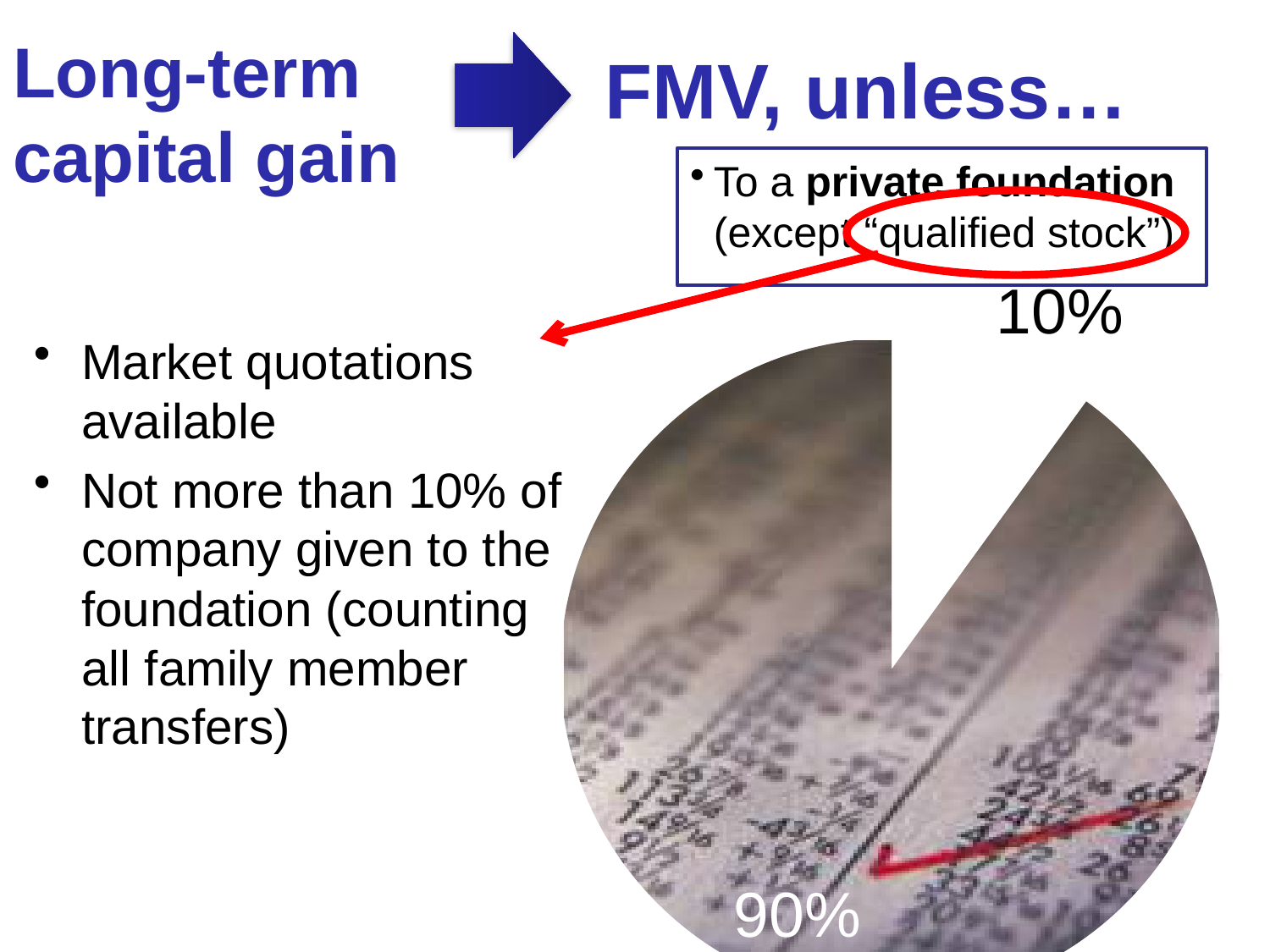
What share of the pie does the cut-out slice represent? 10% What is the value of the smallest slice of the pie chart? 10% Which slice of the pie chart is larger, the one labelled 90% or the one labelled 10%? 90% How many slices does the pie chart show? 2 What is the value of the largest slice of the pie chart? 90% What kind of chart is shown on the slide? pie chart Which slice of the pie chart is shown as a blank cut-out rather than filled? the 10% slice What is the difference between the two slice values in the pie chart? 80 percentage points What share of the pie does the slice labelled 90% represent? 90% What do the two slice values in the pie chart add up to? 100%